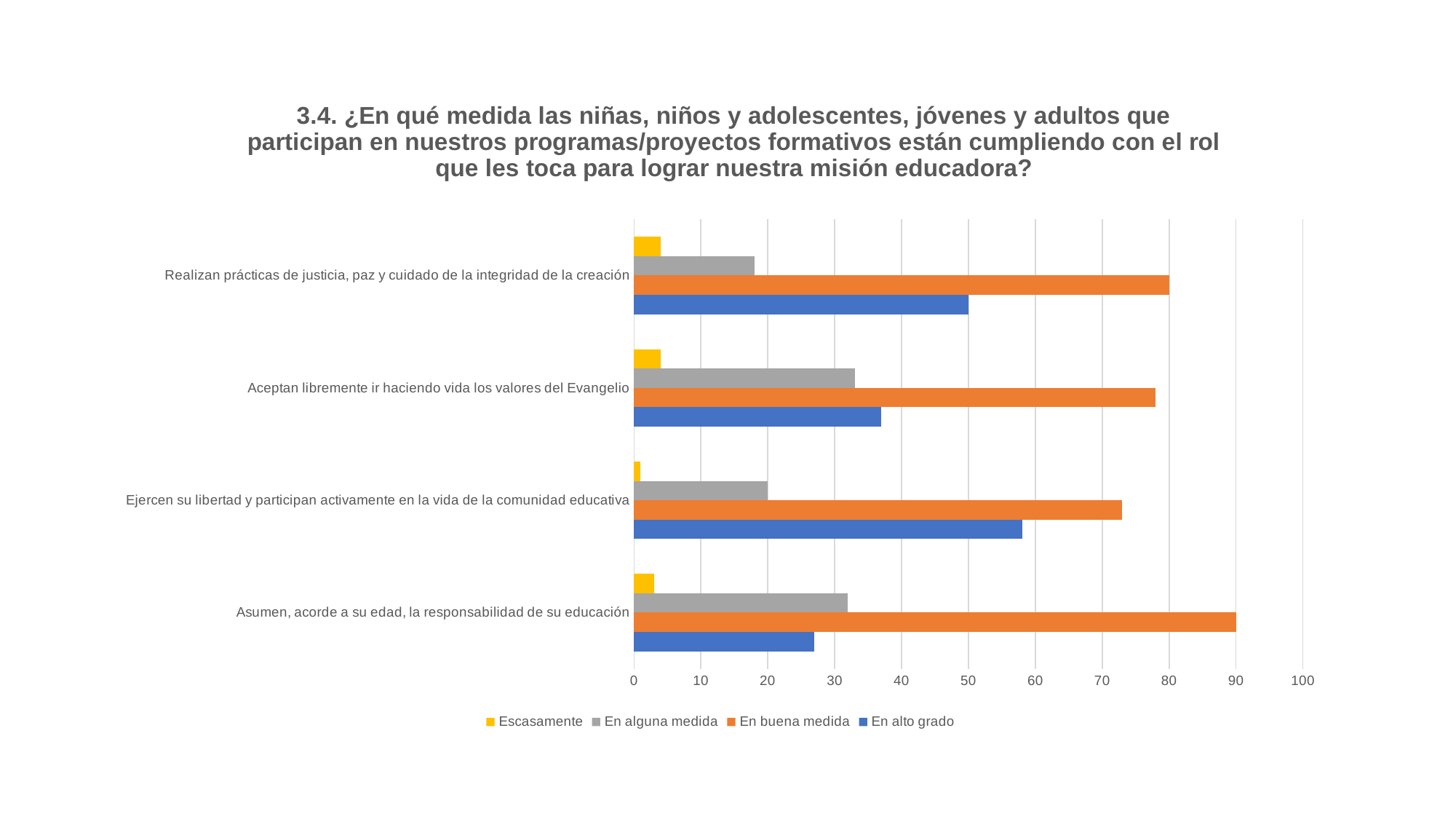
What kind of chart is shown on the slide? bar chart Which series is represented by the orange bars? En buena medida Is the value for 'En buena medida' in 'Ejercen su libertad y participan activamente en la vida de la comunidad educativa' greater or less than 70? greater Is the value for 'En alto grado' in 'Aceptan libremente ir haciendo vida los valores del Evangelio' greater or less than 40? less Which category has the highest value for 'En alto grado'? Ejercen su libertad y participan activamente en la vida de la comunidad educativa Which category has the lowest value for 'En alto grado'? Asumen, acorde a su edad, la responsabilidad de su educación For 'Realizan prácticas de justicia, paz y cuidado de la integridad de la creación', which is larger: 'En buena medida' or 'En alto grado'? En buena medida Which category has the lowest value for 'Escasamente'? Ejercen su libertad y participan activamente en la vida de la comunidad educativa How many series does the legend list? 4 Which category has the highest value for 'En buena medida'? Asumen, acorde a su edad, la responsabilidad de su educación Is the value for 'En alguna medida' in 'Aceptan libremente ir haciendo vida los valores del Evangelio' greater or less than 30? greater How many categories are shown on the chart? 4